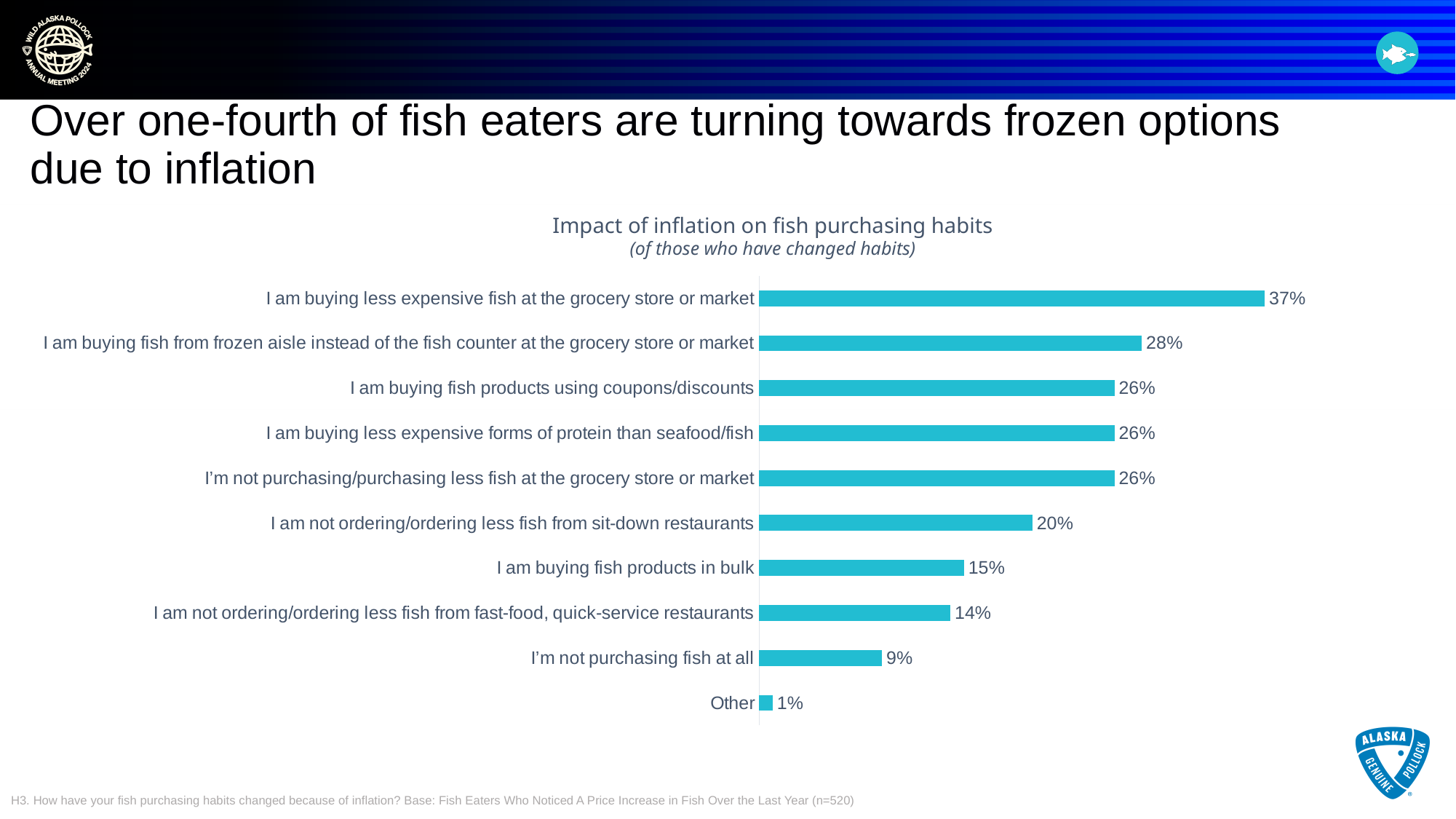
What is the title of the chart? Impact of inflation on fish purchasing habits What percentage of respondents say they are not purchasing fish at all? 9% What percentage of respondents say they are buying fish from the frozen aisle instead of the fish counter at the grocery store or market? 28% How many categories are shown in the chart? 10 What is the difference between the value for buying less expensive fish at the grocery store or market and the value for buying fish from the frozen aisle? 9% Which category has the highest value in the chart? I am buying less expensive fish at the grocery store or market Which category has the lowest value in the chart? Other Which is larger: the value for buying fish products in bulk or the value for not ordering/ordering less fish from sit-down restaurants? I am not ordering/ordering less fish from sit-down restaurants How many categories share the value of 26%? 3 What percentage of respondents say they are buying fish products in bulk? 15% What kind of chart is shown on the slide? Bar chart What is the difference between the value for not ordering/ordering less fish from sit-down restaurants and the value for not ordering/ordering less fish from fast-food, quick-service restaurants? 6%